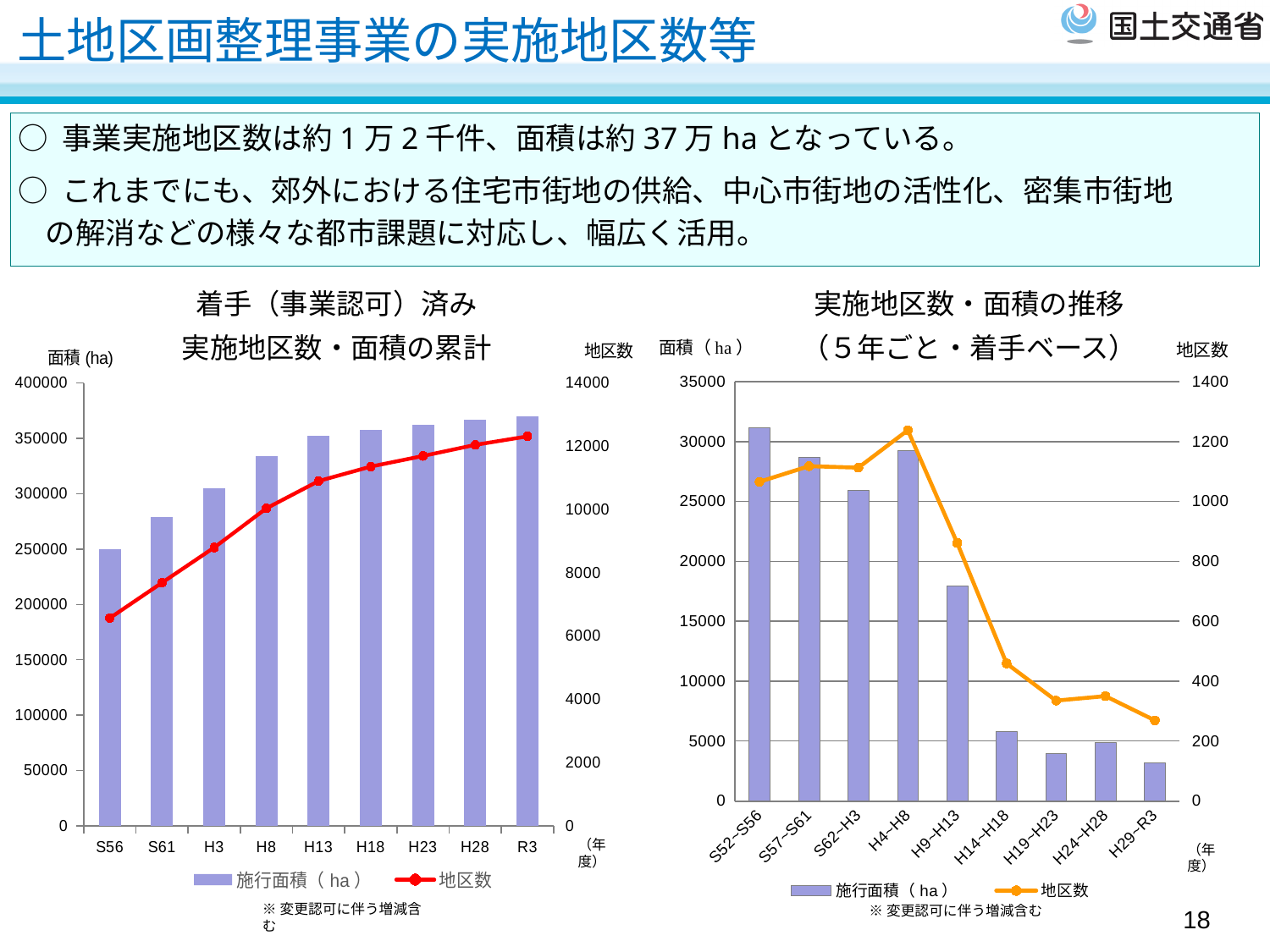
In the right chart (実施地区数・面積の推移), which period has the highest 施行面積 bar? S52~S56 In the left chart (実施地区数・面積の累計), is the 施行面積 value for S56 greater or less than 300000? less In the right chart (実施地区数・面積の推移), which period has the lowest 施行面積 bar? H29~R3 In the right chart (実施地区数・面積の推移), is the 施行面積 value for H9~H13 greater or less than 20000? less In the left chart (実施地区数・面積の累計), which year has the highest 施行面積 bar? R3 What kind of chart is the left chart titled 着手（事業認可）済み 実施地区数・面積の累計? A combined bar and line chart In the left chart (実施地区数・面積の累計), is the 地区数 value for S56 greater or less than 8000? less In the left chart (実施地区数・面積の累計), how many series does the legend list? 2 In the left chart (実施地区数・面積の累計), how many fiscal-year categories are shown on the x axis? 9 In the right chart (実施地区数・面積の推移), which period has the highest 地区数 value? H4~H8 In the left chart (実施地区数・面積の累計), do the 地区数 values rise or fall from S56 to R3? rise In the right chart (実施地区数・面積の推移), which is larger, the 施行面積 for S52~S56 or for S57~S61? S52~S56